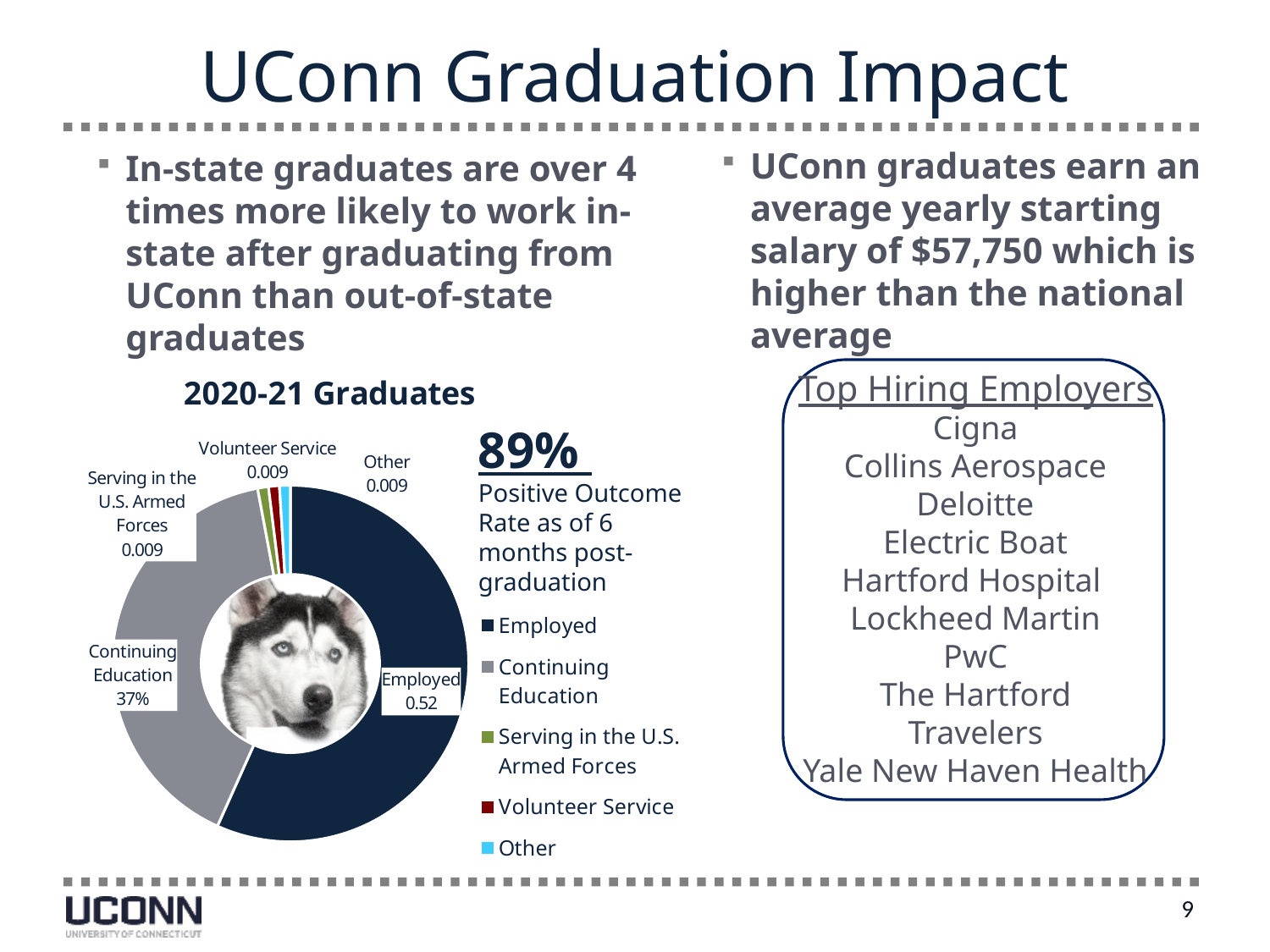
How many categories are shown in the 2020-21 Graduates chart? 5 What kind of chart is the 2020-21 Graduates chart? Doughnut (pie) chart In the 2020-21 Graduates chart, which is larger, Employed or Continuing Education? Employed In the 2020-21 Graduates chart, what is the value shown for Other? 0.009 What share of the 2020-21 Graduates chart does Continuing Education take? 37% In the 2020-21 Graduates chart, which category has the largest slice? Employed In the 2020-21 Graduates chart, what is the value shown for Continuing Education? 37% How many entries does the legend of the 2020-21 Graduates chart list? 5 In the 2020-21 Graduates chart, what is the value shown for Volunteer Service? 0.009 What is the title of the chart on the slide? 2020-21 Graduates In the 2020-21 Graduates chart, what is the value shown for Employed? 0.52 In the 2020-21 Graduates chart, what is the value shown for Serving in the U.S. Armed Forces? 0.009